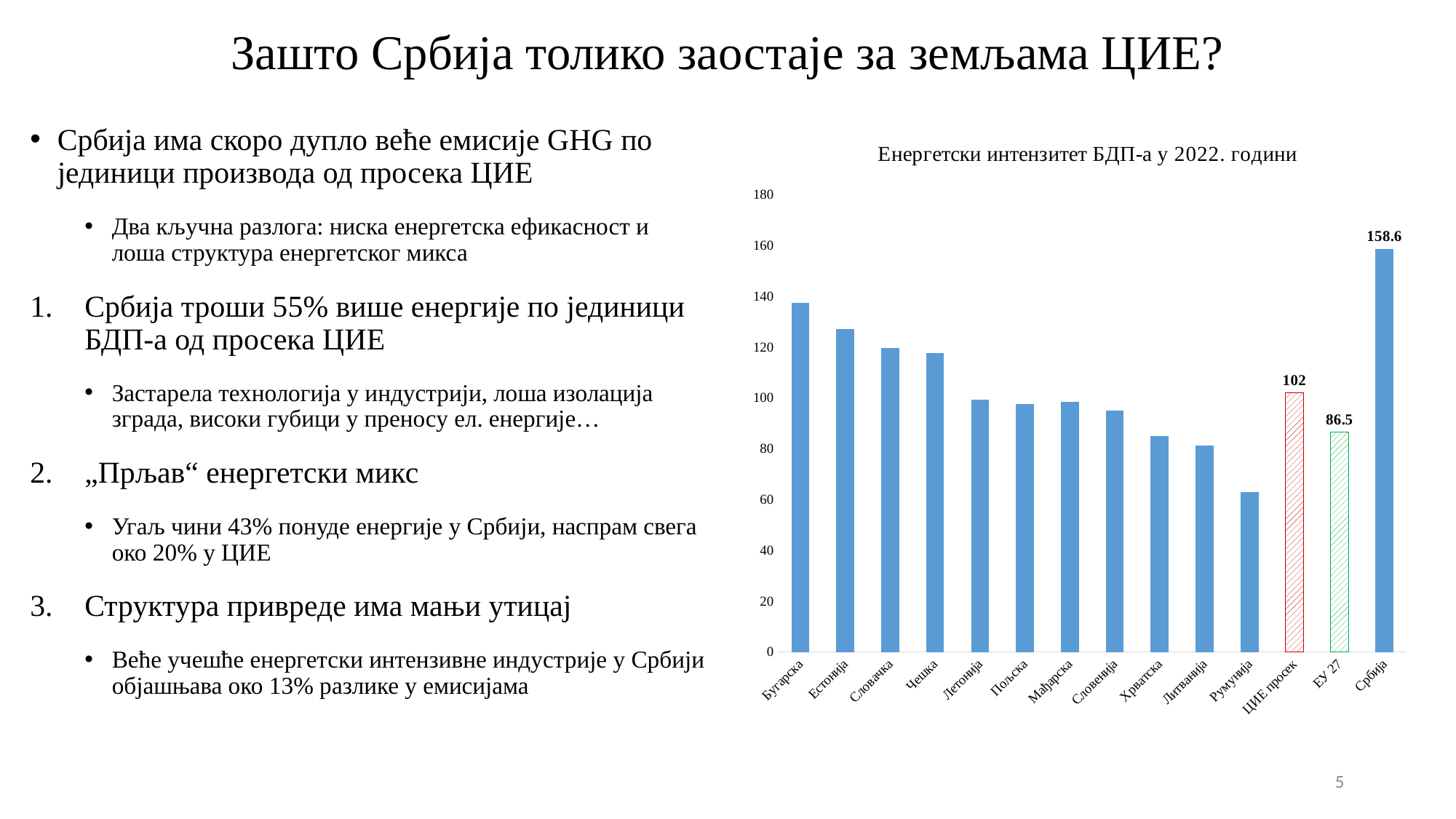
Which category has the lowest value in the chart? Румунија Is the value for Бугарска greater or less than 120? greater Is the value for Румунија greater or less than 80? less What is the value for Србија in the chart? 158.6 How many categories are shown on the x axis of the chart? 14 What is the difference between the values for Србија and ЦИЕ просек? 56.6 What is the difference between the values for ЦИЕ просек and ЕУ 27? 15.5 Which category has the highest value in the chart? Србија Which has a larger value, Бугарска or Естонија? Бугарска What is the value for ЦИЕ просек in the chart? 102 What type of chart is shown on the slide? bar chart What is the value for ЕУ 27 in the chart? 86.5